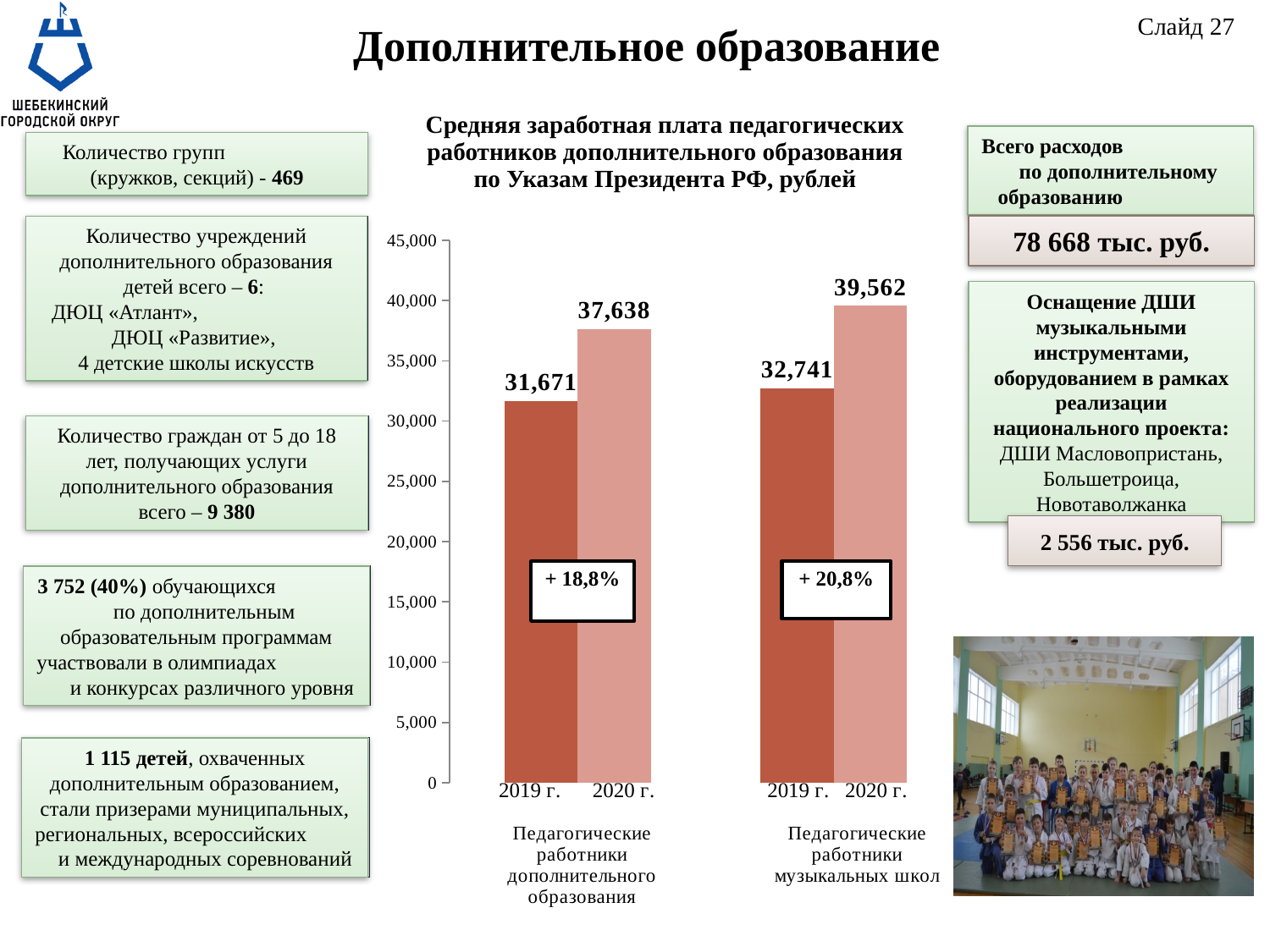
Which bar shows the lowest average salary on the chart? Педагогические работники дополнительного образования, 2019 г. Which bar shows the highest average salary on the chart? Педагогические работники музыкальных школ, 2020 г. By how much did the average salary of supplementary education teaching staff increase from 2019 to 2020, in rubles? 5,967 What was the average salary of teaching staff in supplementary education (Педагогические работники дополнительного образования) in 2020? 37,638 What was the average salary of teaching staff in supplementary education (Педагогические работники дополнительного образования) in 2019? 31,671 By how much did the average salary of music school teaching staff increase from 2019 to 2020, in rubles? 6,821 What type of chart is used to show the average salaries of teaching staff? Bar chart What was the average salary of music school teaching staff (Педагогические работники музыкальных школ) in 2020? 39,562 What was the average salary of music school teaching staff (Педагогические работники музыкальных школ) in 2019? 32,741 What percentage increase is shown for the salary of music school teaching staff from 2019 to 2020? + 20,8% Which was higher in 2020: the average salary of supplementary education teaching staff or of music school teaching staff? Педагогические работники музыкальных школ How many bars are plotted on the salary chart? 4